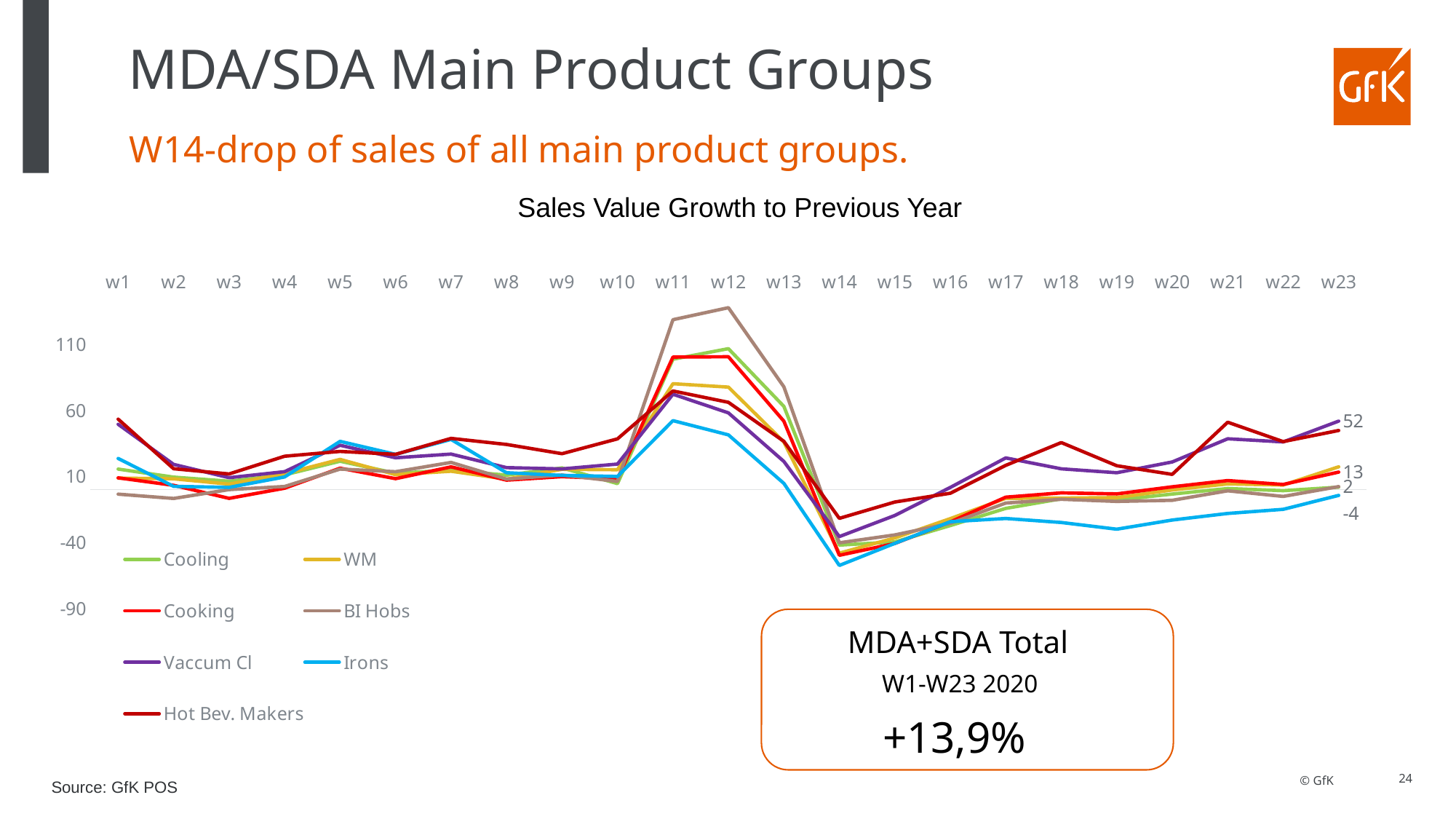
What kind of chart is shown on the slide? line chart Is the value for BI Hobs at w12 greater or less than 110? greater What is the difference between Vaccum Cl and Irons at w23? 56 At w23, which is larger: Vaccum Cl or Irons? Vaccum Cl What is the value for Vaccum Cl at w23? 52 Which series has the highest value at w12? BI Hobs How many weeks are plotted along the x axis? 23 What is the title of the chart? Sales Value Growth to Previous Year Which series has the lowest value at w14? Irons What is the MDA+SDA Total growth for W1-W23 2020 shown in the box? +13,9% How many series does the legend list? 7 What is the value for Irons at w23? -4